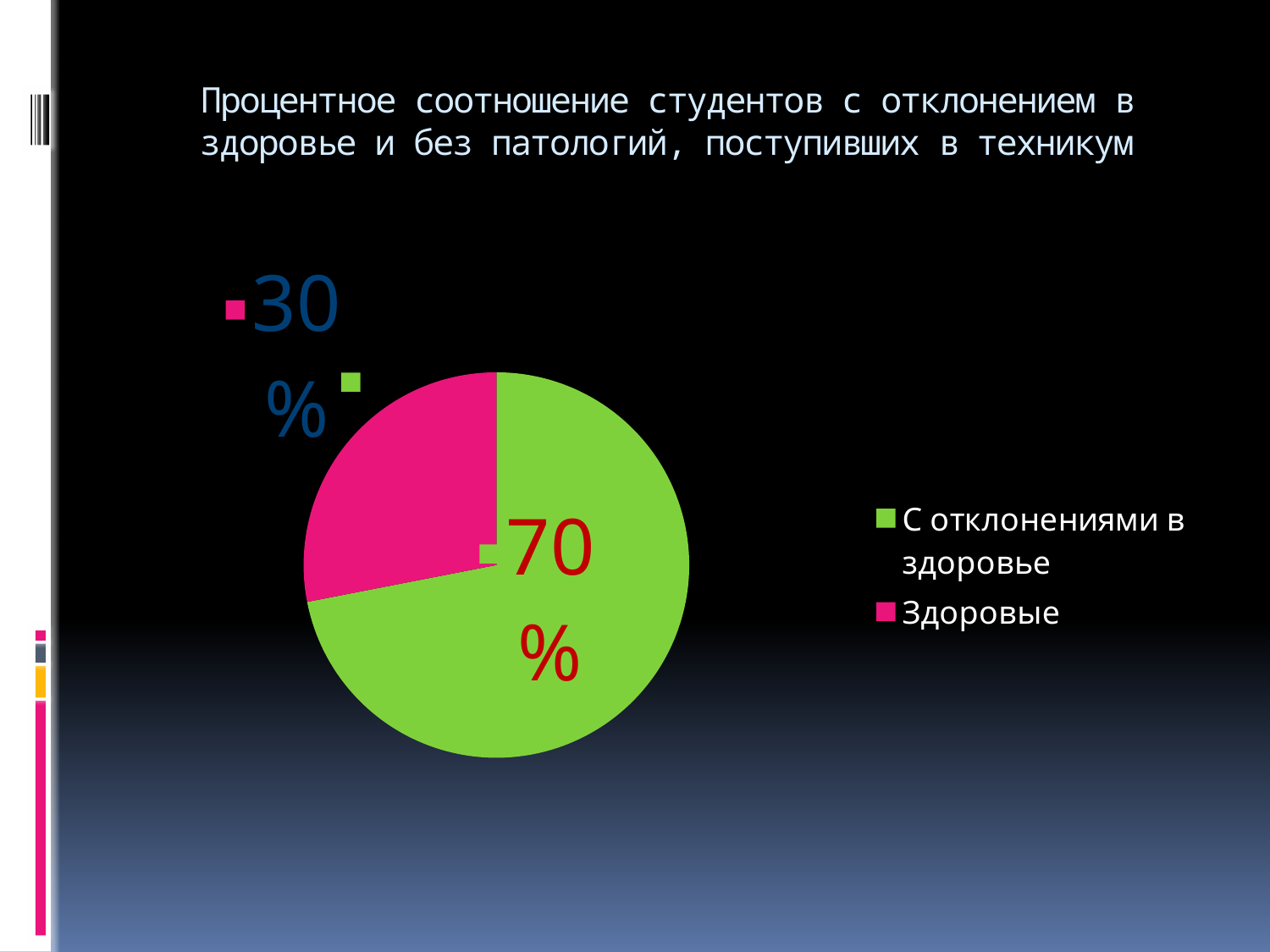
What kind of chart is shown on the slide? pie chart What share of the pie does the 'Здоровые' slice represent? 30% Which is larger: the share for 'Здоровые' or the share for 'С отклонениями в здоровье'? С отклонениями в здоровье How many entries does the legend list? 2 Which category has the largest share of the pie? С отклонениями в здоровье What is the difference in percentage points between 'С отклонениями в здоровье' and 'Здоровые'? 40 What percentage of students are shown as 'С отклонениями в здоровье'? 70% What percentage of students are shown as 'Здоровые'? 30% Which category has the smallest share of the pie? Здоровые What colour is the slice for 'Здоровые'? pink What colour is the slice for 'С отклонениями в здоровье'? green How many categories does the pie chart have? 2